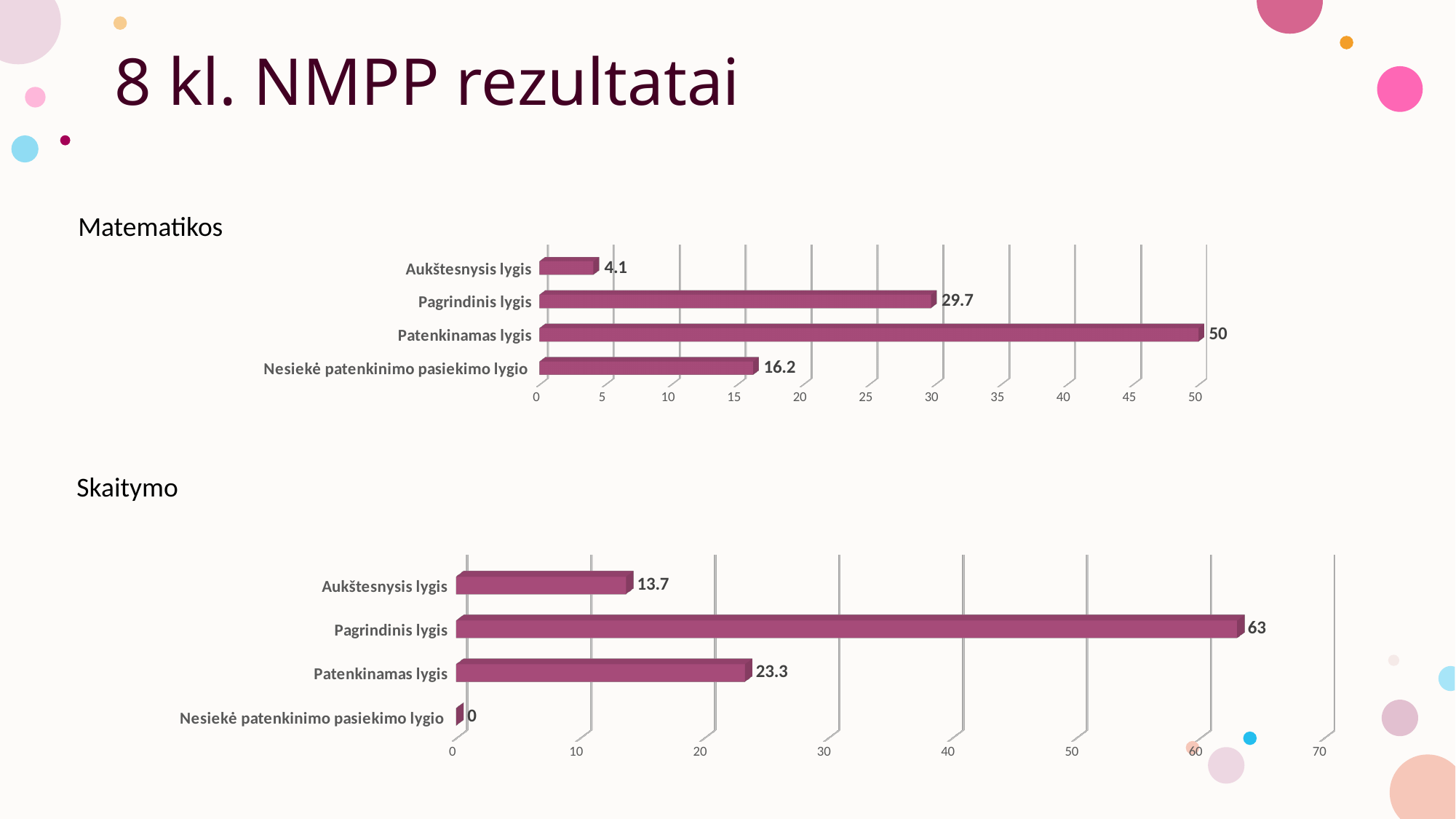
In the Skaitymo chart, which is larger: Aukštesnysis lygis or Patenkinamas lygis? Patenkinamas lygis What type of chart is the Matematikos chart? Bar chart In the Matematikos chart, what is the value for Pagrindinis lygis? 29.7 In the Skaitymo chart, which category has the highest value? Pagrindinis lygis In the Skaitymo chart, what is the value for Patenkinamas lygis? 23.3 In the Matematikos chart, which category has the lowest value? Aukštesnysis lygis In the Matematikos chart, what is the value for Nesiekė patenkinimo pasiekimo lygio? 16.2 In the Matematikos chart, what is the difference between Patenkinamas lygis and Pagrindinis lygis? 20.3 How many categories does the Skaitymo chart show? 4 In the Matematikos chart, which category has the highest value? Patenkinamas lygis In the Skaitymo chart, which category has the lowest value? Nesiekė patenkinimo pasiekimo lygio In the Skaitymo chart, what is the value for Aukštesnysis lygis? 13.7